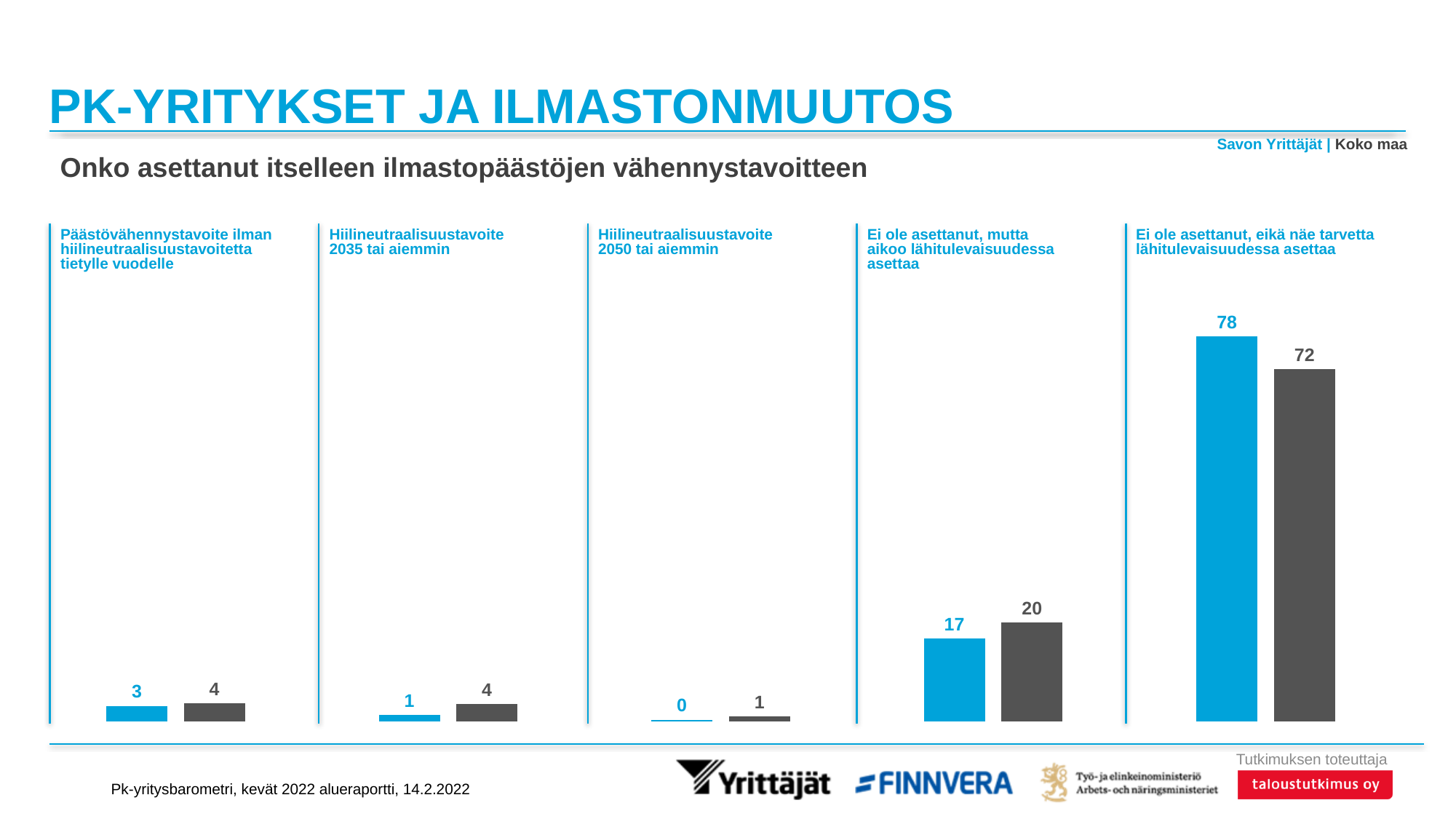
Which category has the highest value for Koko maa? Ei ole asettanut, eikä näe tarvetta lähitulevaisuudessa asettaa What is the value for Savon Yrittäjät in the category "Ei ole asettanut, eikä näe tarvetta lähitulevaisuudessa asettaa"? 78 What is the value for Koko maa in the category "Ei ole asettanut, mutta aikoo lähitulevaisuudessa asettaa"? 20 How many categories are shown in the chart? 5 Which category has the lowest value for Savon Yrittäjät? Hiilineutraalisuustavoite 2050 tai aiemmin Which colour represents Savon Yrittäjät in the chart? Blue What is the value for Koko maa in the category "Hiilineutraalisuustavoite 2035 tai aiemmin"? 4 What is the value for Savon Yrittäjät in the category "Hiilineutraalisuustavoite 2050 tai aiemmin"? 0 What is the difference between the Savon Yrittäjät and Koko maa values in the category "Ei ole asettanut, eikä näe tarvetta lähitulevaisuudessa asettaa"? 6 How many series does the legend list? 2 In the category "Ei ole asettanut, mutta aikoo lähitulevaisuudessa asettaa", which is larger: Savon Yrittäjät or Koko maa? Koko maa What kind of chart is shown on the slide? Bar chart